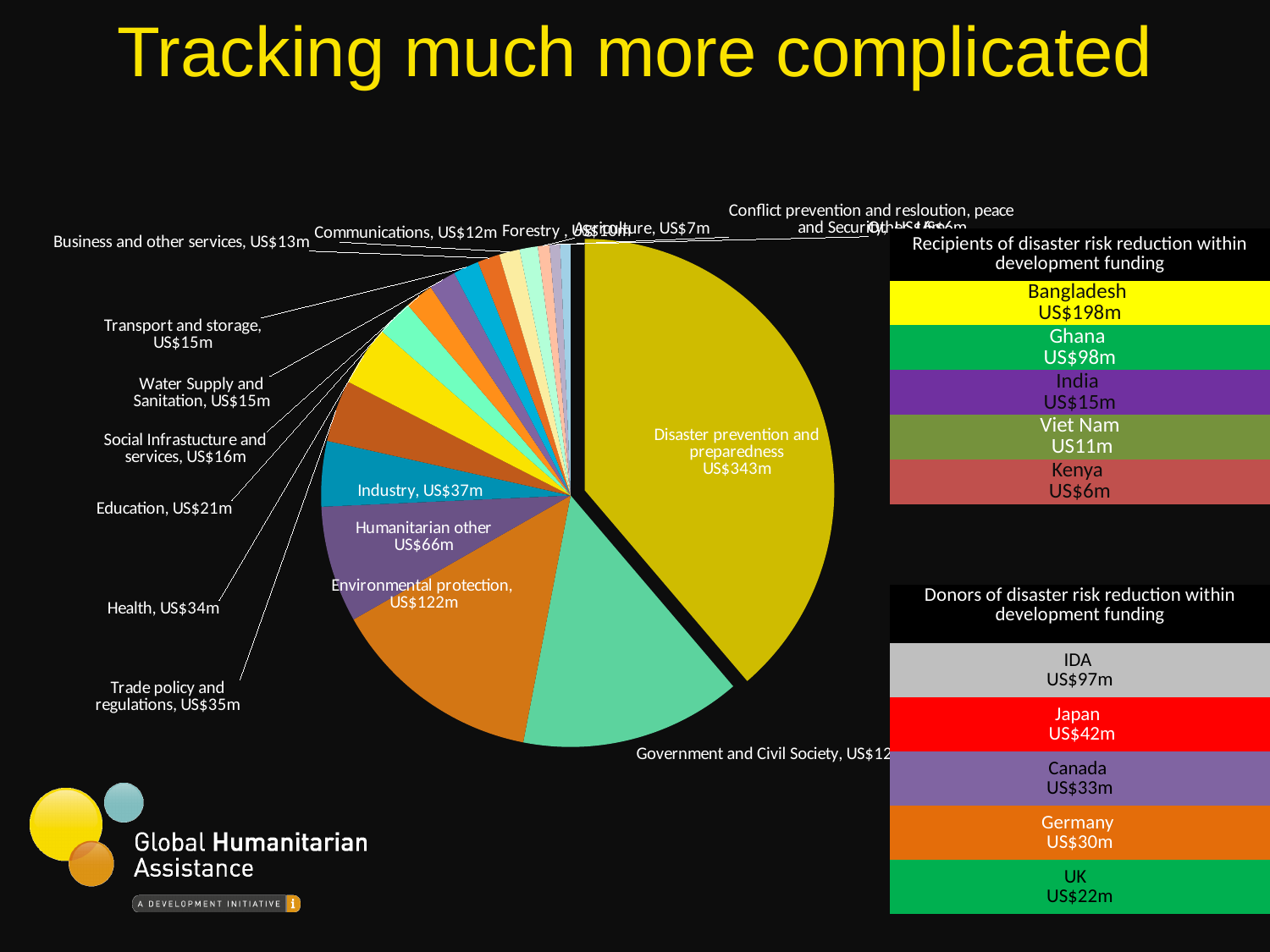
What is the value for Humanitarian other in the pie chart? US$66m Which is larger in the pie chart, Industry or Education? Industry Which category has the largest slice in the pie chart? Disaster prevention and preparedness What kind of chart is shown on the slide? pie chart What is the difference between Disaster prevention and preparedness and Environmental protection in the pie chart? US$221m What is the value for Agriculture in the pie chart? US$7m What is the value for Education in the pie chart? US$21m What is the value for Environmental protection in the pie chart? US$122m What is the difference between Environmental protection and Humanitarian other in the pie chart? US$56m What is the value for Business and other services in the pie chart? US$13m What is the value for Industry in the pie chart? US$37m What is the value for Disaster prevention and preparedness in the pie chart? US$343m